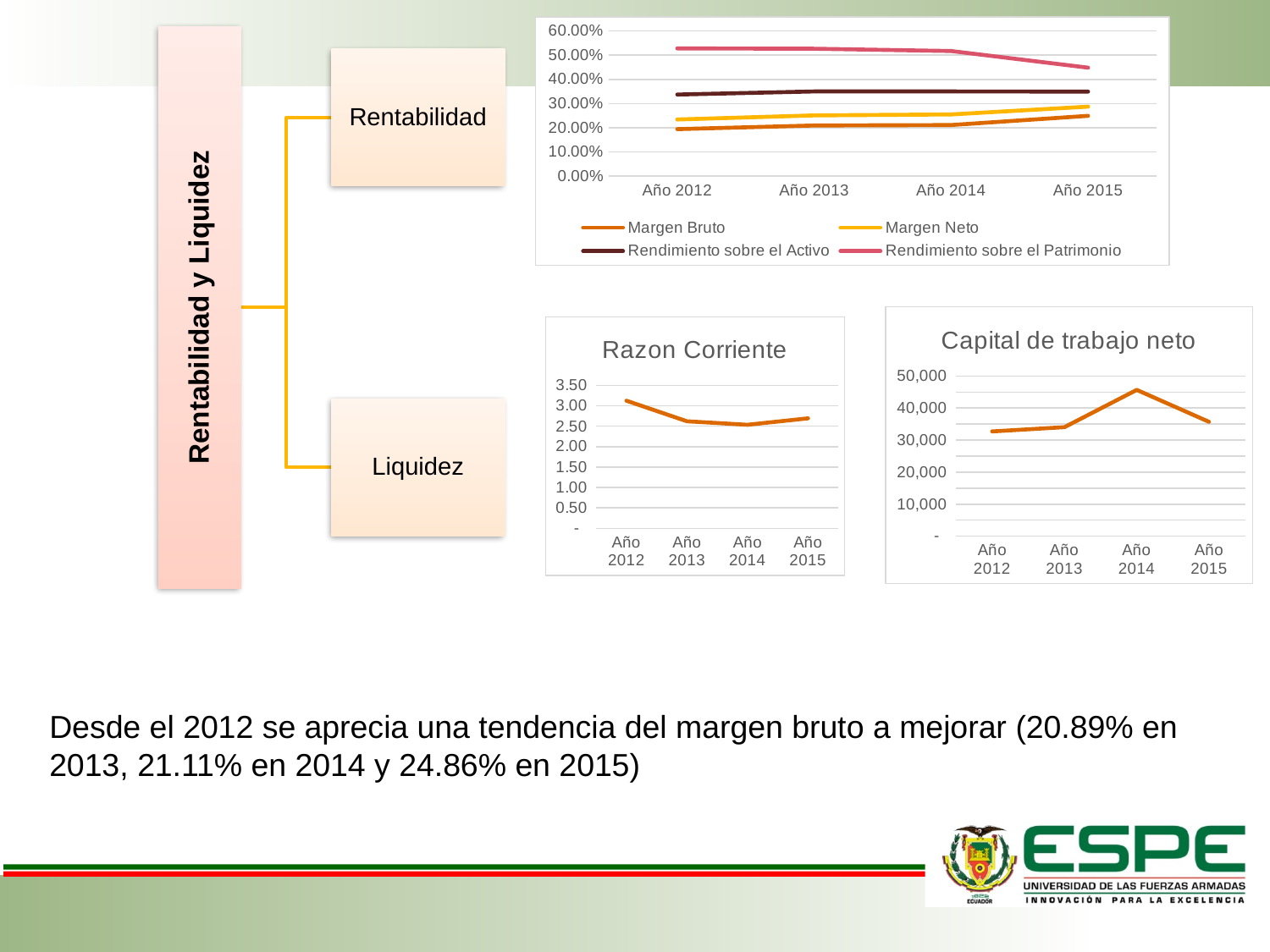
In the top-right chart, is the value for Margen Bruto in Año 2012 greater or less than 30.00%? less In the Razon Corriente chart, is the value for Año 2012 greater or less than 3.00? greater In the top-right chart, how many years are shown on the x axis? 4 In the top-right chart, how many series does the legend list? 4 In the top-right chart, is the value for Rendimiento sobre el Patrimonio in Año 2012 greater or less than 40.00%? greater In the top-right chart, which series has the highest value in Año 2012? Rendimiento sobre el Patrimonio What kind of chart is the Capital de trabajo neto chart? Line chart In the Razon Corriente chart, which year has the highest value? Año 2012 In the top-right chart, does Rendimiento sobre el Patrimonio rise or fall from Año 2012 to Año 2015? Fall In the Capital de trabajo neto chart, which year has the highest value? Año 2014 What kind of chart is the top-right chart with Margen Bruto and Margen Neto? Line chart